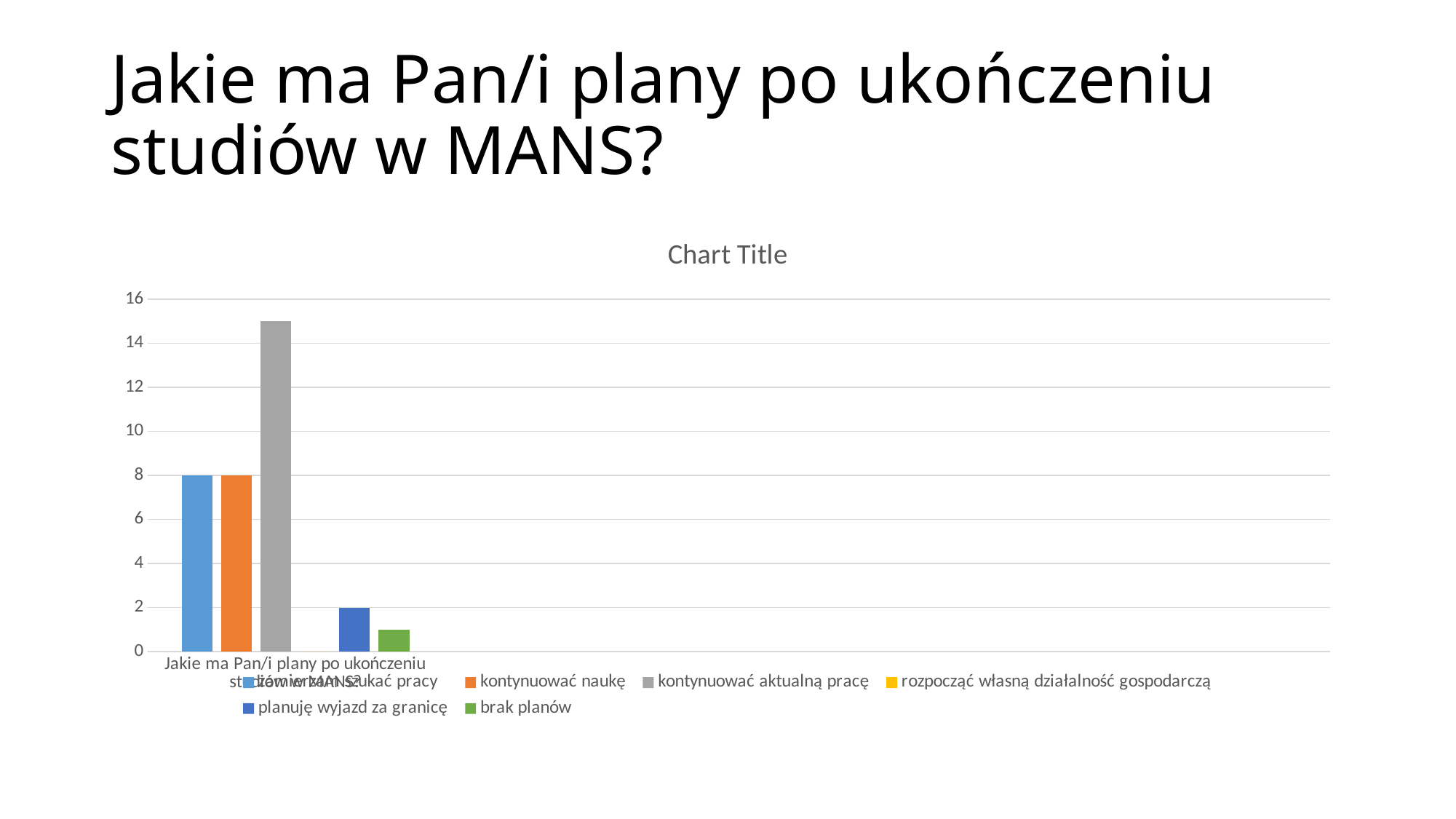
What colour is the bar for "kontynuować aktualną pracę"? gray Is the value for "brak planów" greater or less than 2? less Which is larger, the value for "planuję wyjazd za granicę" or the value for "brak planów"? planuję wyjazd za granicę How many series does the legend list? 6 What is the title shown above the chart? Chart Title What is the value for the series "planuję wyjazd za granicę"? 2 Which is larger, the value for "kontynuować aktualną pracę" or the value for "kontynuować naukę"? kontynuować aktualną pracę What kind of chart is shown on the slide? bar chart What is the value for the series "kontynuować naukę"? 8 What is the difference between the value for "kontynuować naukę" and the value for "planuję wyjazd za granicę"? 6 Is the value for "kontynuować aktualną pracę" greater or less than 14? greater Which series has the highest bar? kontynuować aktualną pracę